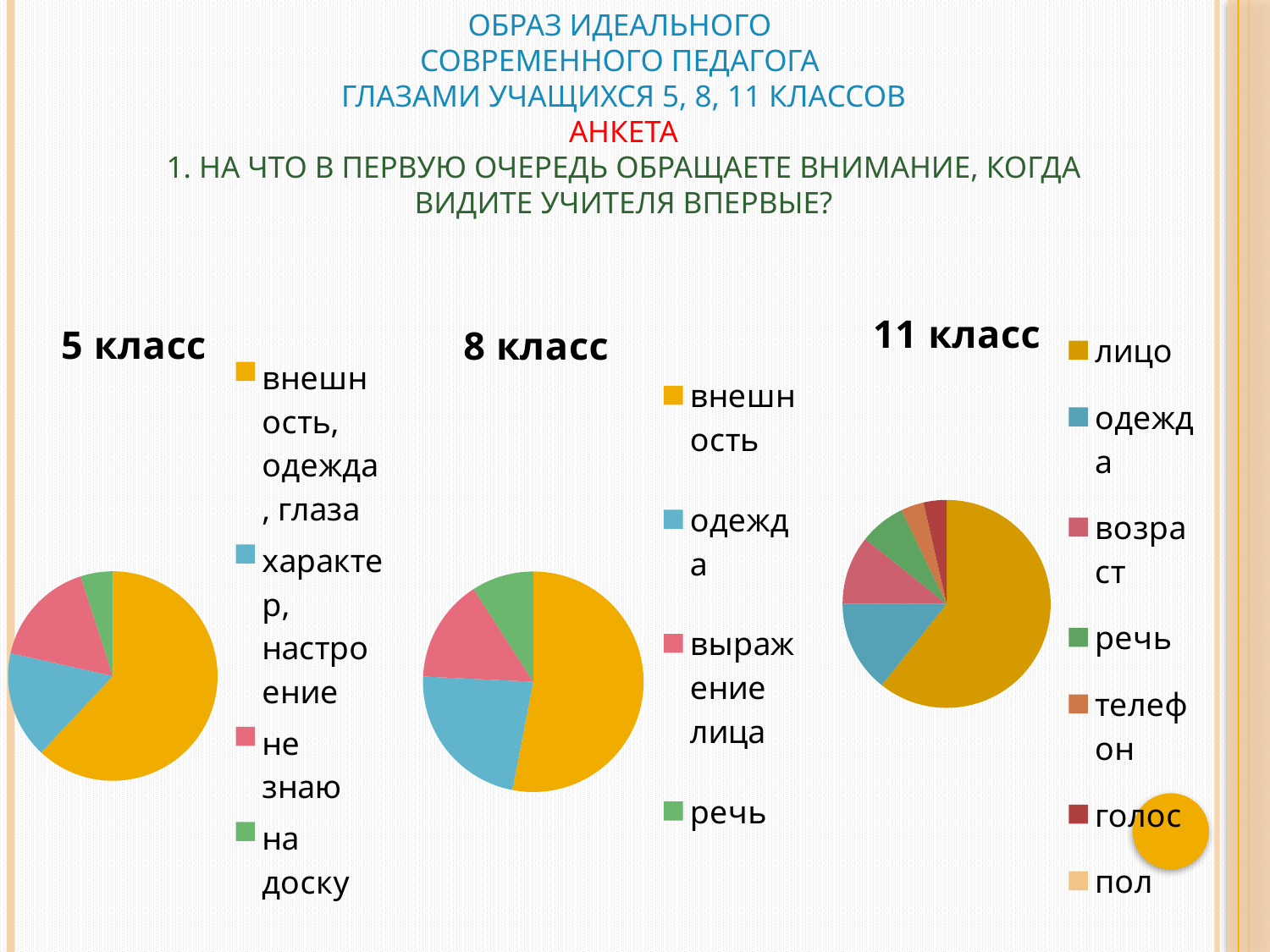
In the "11 класс" chart, which category has the largest slice? лицо In the "8 класс" chart, which category has the largest slice? внешность What kind of chart is the "5 класс" chart? pie chart How many categories does the legend of the "5 класс" chart list? 4 In the "11 класс" chart, which slice is larger: одежда or возраст? одежда In the "5 класс" chart, which category has the largest slice? внешность, одежда, глаза What colour is the largest slice in the "11 класс" chart? yellow In the "8 класс" chart, which category has the smallest slice? речь How many categories does the legend of the "11 класс" chart list? 7 In the "5 класс" chart, which category has the smallest slice? на доску In the "8 класс" chart, which slice is larger: одежда or выражение лица? одежда How many categories does the legend of the "8 класс" chart list? 4